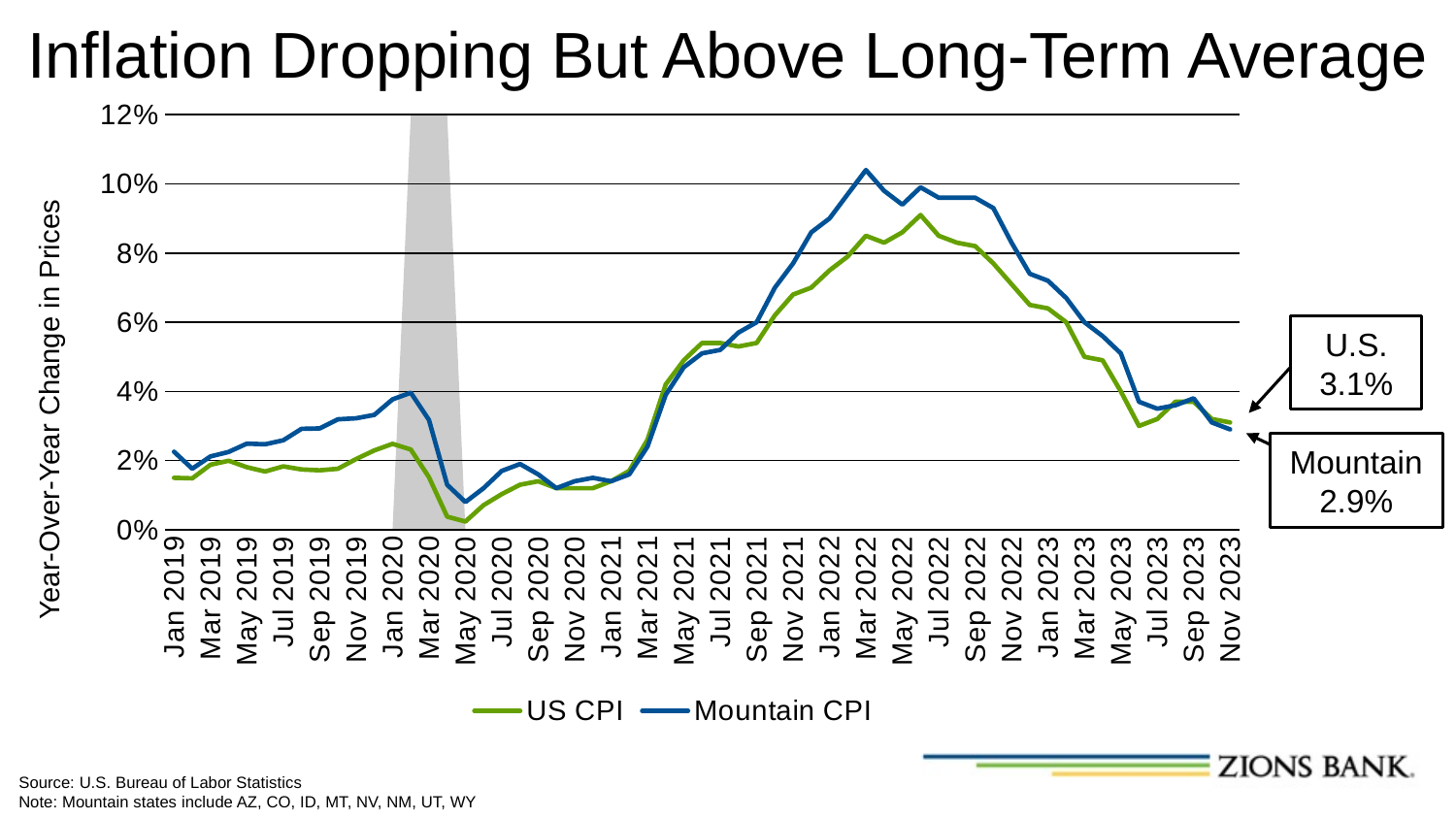
Is the peak value of the Mountain CPI line greater or less than 10%? greater What is the difference between the labeled U.S. value (3.1%) and the labeled Mountain value (2.9%)? 0.2% What kind of chart is shown on the slide? line chart What is the latest Mountain CPI value labeled on the chart? 2.9% How many series does the legend list? 2 What is the latest U.S. CPI value labeled on the chart? 3.1% At the end of the chart, which is higher: the U.S. CPI or the Mountain CPI? U.S. CPI From mid-2022 to Nov 2023, does the US CPI line rise or fall? fall Is the peak value of the US CPI line greater or less than 10%? less Which series reaches the higher peak on the chart, US CPI or Mountain CPI? Mountain CPI What is the title of the chart on the slide? Inflation Dropping But Above Long-Term Average Is the US CPI value in May 2020 greater or less than 2%? less